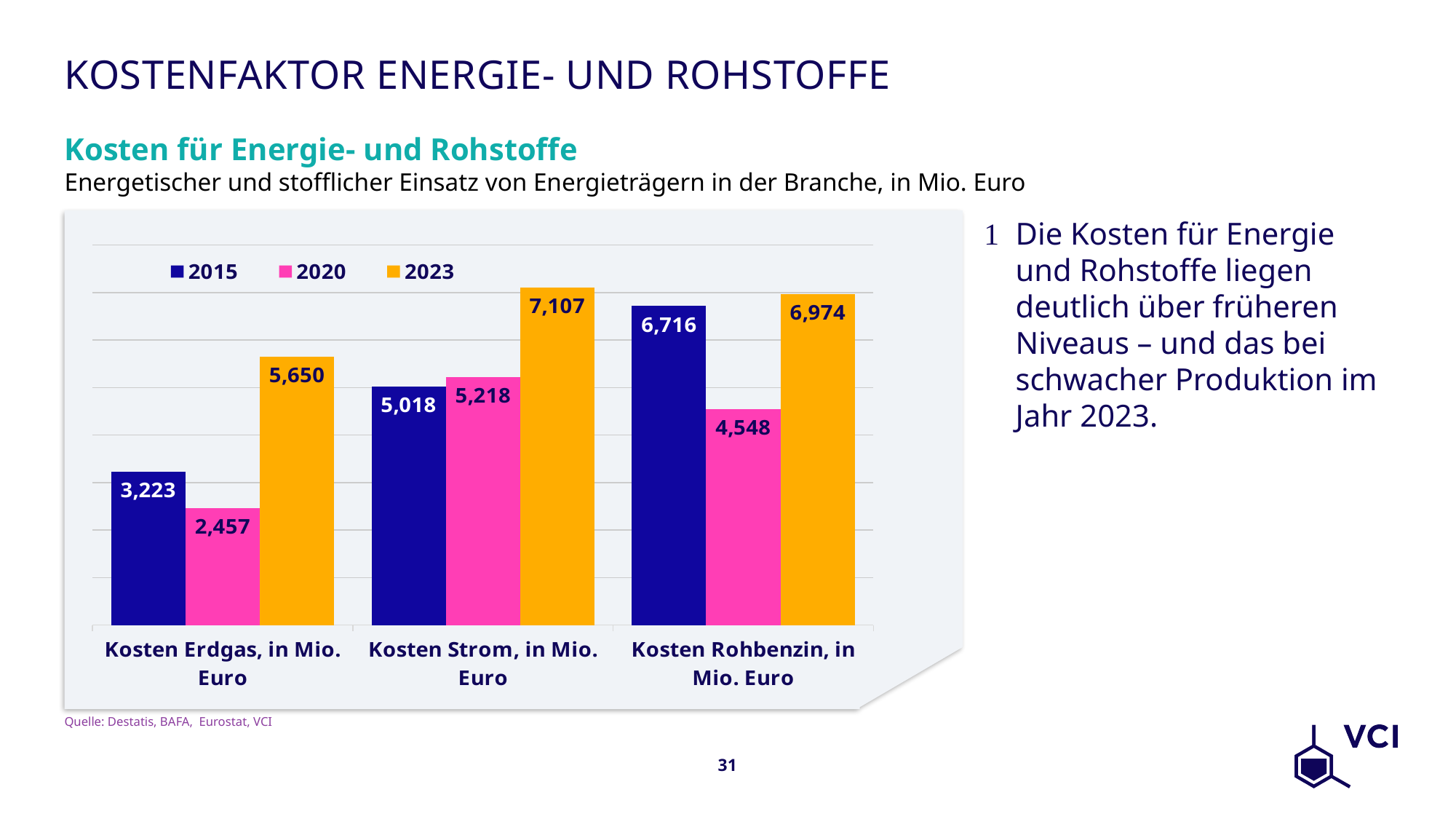
Which category has the lowest value in 2020? Kosten Erdgas, in Mio. Euro What is the value for Kosten Strom in 2023? 7,107 Which is larger for Kosten Rohbenzin: the 2015 value or the 2023 value? 2023 How many categories are shown on the x axis? 3 How many series does the legend list? 3 What is the difference between the 2020 and 2015 values for Kosten Strom? 200 What is the difference between the 2023 and 2015 values for Kosten Erdgas? 2,427 What is the value for Kosten Rohbenzin in 2020? 4,548 What kind of chart is shown on the slide? Bar chart What is the value for Kosten Erdgas in 2015? 3,223 Which years are listed in the chart legend? 2015, 2020, 2023 Which category has the highest value in 2023? Kosten Strom, in Mio. Euro